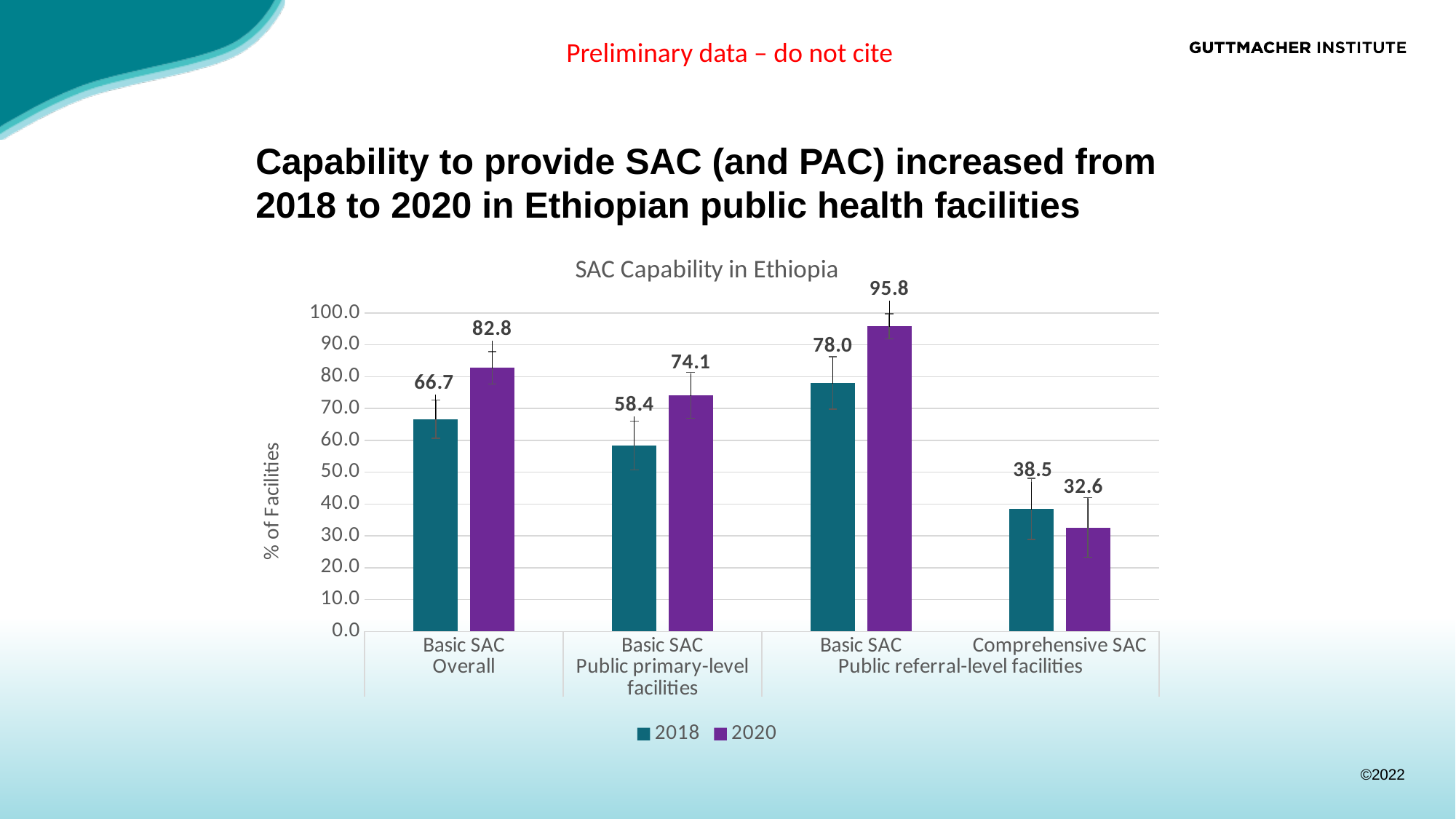
What is the 2020 value for Basic SAC Overall? 82.8 What is the 2018 value for Comprehensive SAC in public referral-level facilities? 38.5 Which category has the lowest 2018 value? Comprehensive SAC, Public referral-level facilities Which category has the highest 2020 value? Basic SAC, Public referral-level facilities What is the 2020 value for Basic SAC in public referral-level facilities? 95.8 What is the label of the y axis? % of Facilities What is the difference between the 2020 and 2018 values for Basic SAC Overall? 16.1 What kind of chart is shown? Bar chart How many categories are shown on the x axis? 4 How many series does the legend list? 2 What is the 2018 value for Basic SAC in public primary-level facilities? 58.4 For Comprehensive SAC in public referral-level facilities, which year has the larger value, 2018 or 2020? 2018